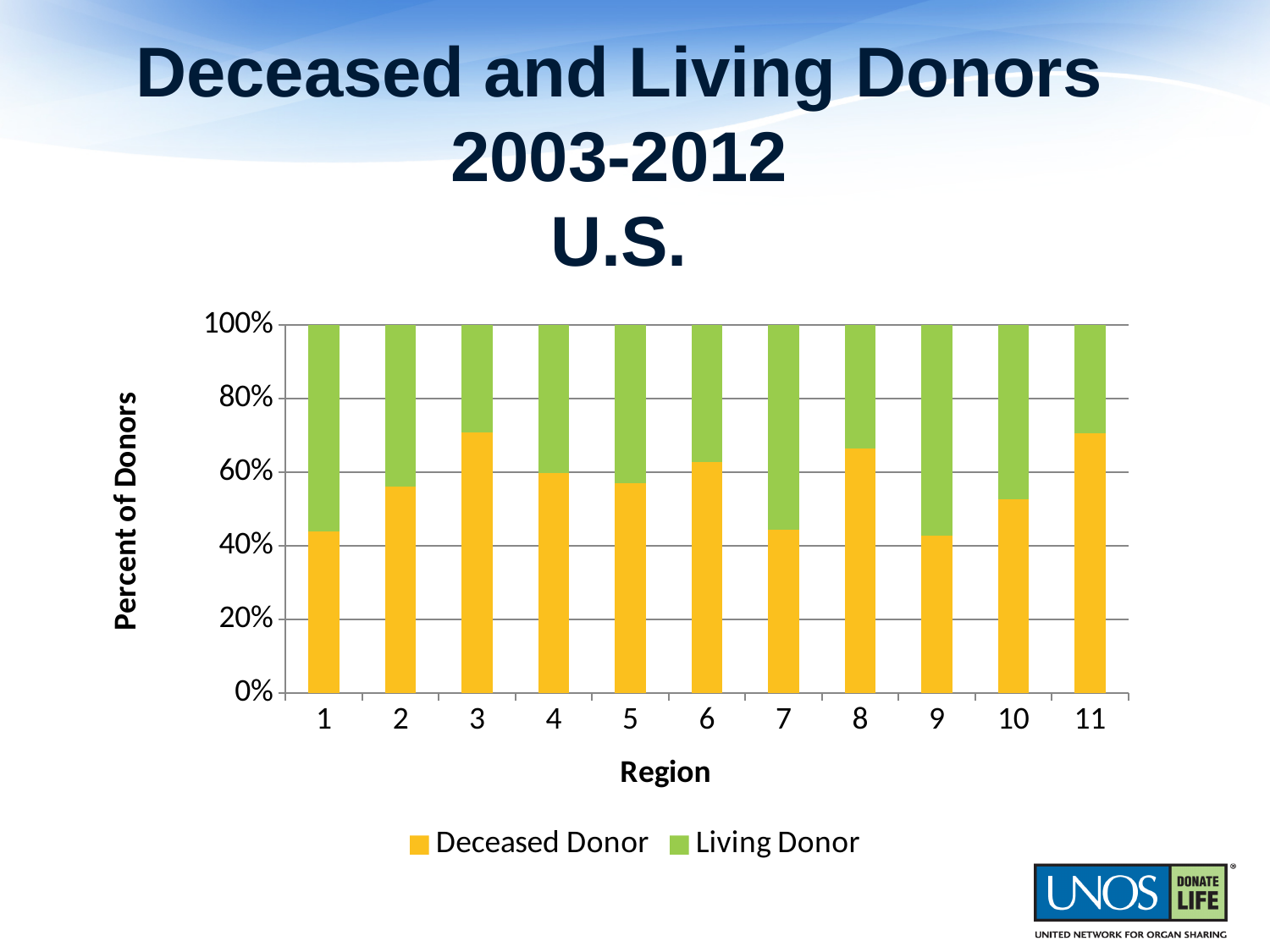
How many series does the chart's legend list? 2 What is the label of the y axis of the chart? Percent of Donors Is the Deceased Donor value for Region 8 greater or less than 60%? greater What are the two series named in the chart's legend? Deceased Donor and Living Donor Is the Deceased Donor value for Region 1 greater or less than 60%? less Which region has the larger Deceased Donor share, Region 3 or Region 1? Region 3 What kind of chart is shown on the slide? bar chart What is the total height of each stacked bar in the chart? 100% Is the Deceased Donor value for Region 9 greater or less than 60%? less How many regions are shown on the x axis of the chart? 11 Which region has the larger Living Donor share, Region 9 or Region 8? Region 9